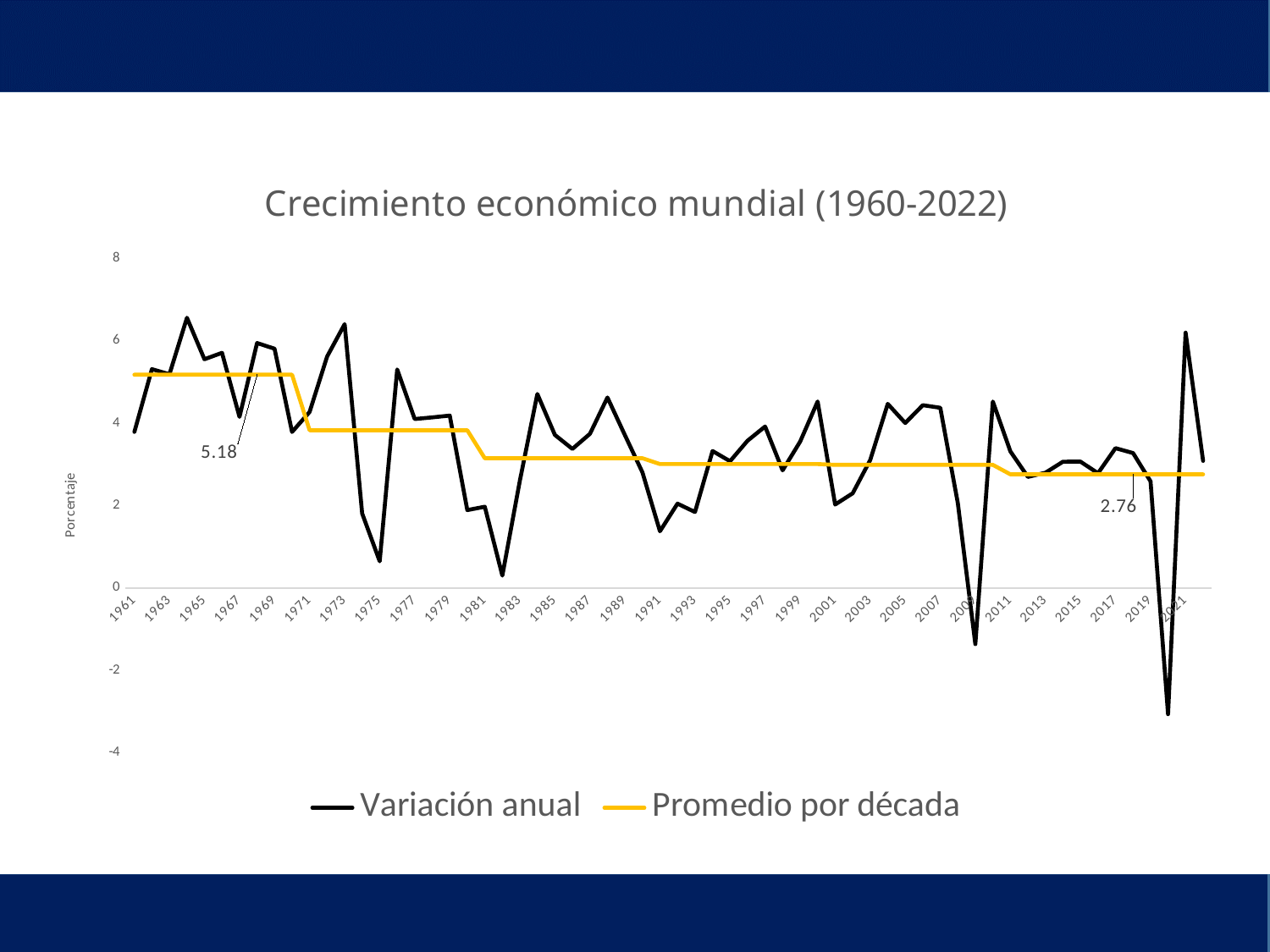
What value is labelled on the Promedio por década line for the 2010s? 2.76 What is the difference between the two labelled Promedio por década values, 5.18 and 2.76? 2.42 Is the Variación anual value for 2020 greater or less than 0? less Which labelled Promedio por década value is larger, the one for the 1960s or the one for the 2010s? the 1960s (5.18) Is the Variación anual value for 1975 greater or less than 2? less What is the title of the chart? Crecimiento económico mundial (1960-2022) Does the Promedio por década line generally rise or fall from 1961 to 2021? fall What value is labelled on the Promedio por década line for the 1960s? 5.18 What kind of chart is shown on the slide? line chart Is the Variación anual value for 1964 greater or less than 6? greater How many series does the legend list? 2 What label is shown on the vertical axis? Porcentaje